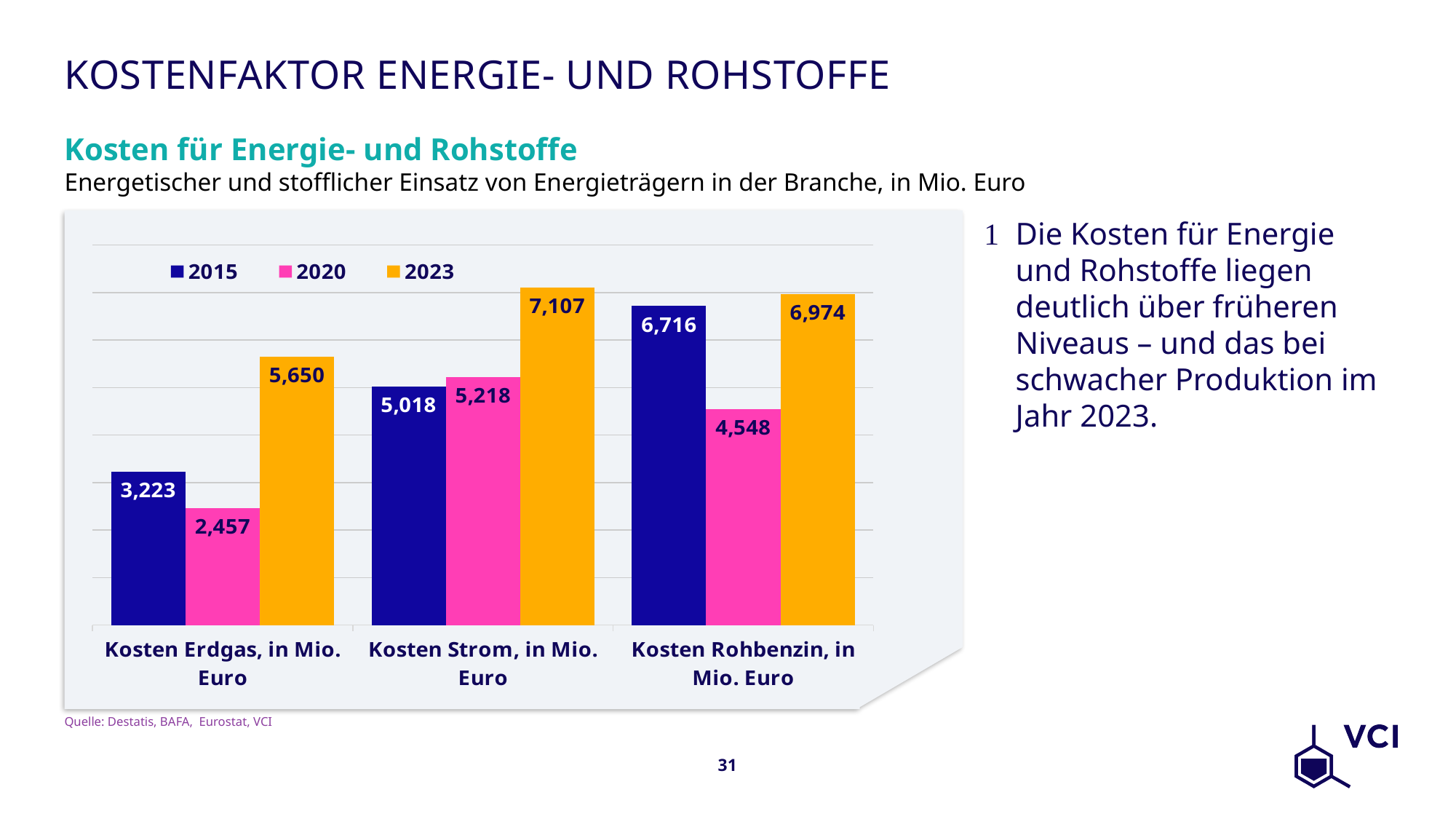
What is the value for Kosten Strom in 2023? 7,107 What is the value for Kosten Erdgas in 2015? 3,223 How many categories are shown on the x axis? 3 Which is larger for Kosten Rohbenzin: the 2015 value or the 2023 value? 2023 What is the value for Kosten Rohbenzin in 2020? 4,548 Which category has the highest value in 2023? Kosten Strom, in Mio. Euro What is the difference between the 2020 and 2015 values for Kosten Strom? 200 How many series does the legend list? 3 Which category has the lowest value in 2020? Kosten Erdgas, in Mio. Euro Which years are listed in the chart legend? 2015, 2020, 2023 What is the difference between the 2023 and 2015 values for Kosten Erdgas? 2,427 What kind of chart is shown on the slide? Bar chart